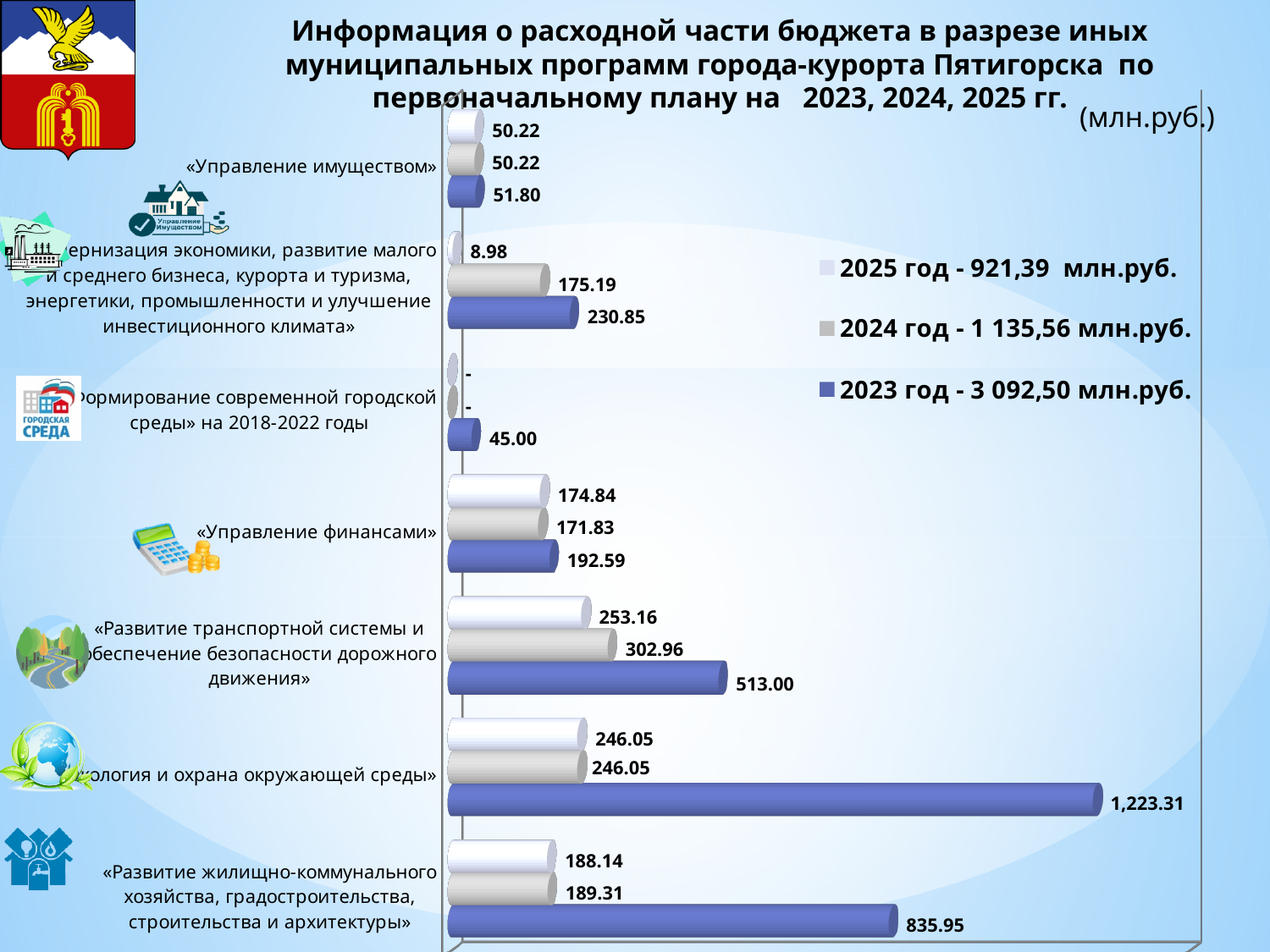
How many program categories are plotted on the chart? 7 Which is larger for «Развитие транспортной системы и обеспечение безопасности дорожного движения»: the 2023 value or the 2025 value? 2023 value What type of chart is shown on the slide? bar chart According to the legend, what is the total for 2023 год? 3 092,50 млн.руб. What is the 2023 value for «Формирование современной городской среды» на 2018-2022 годы? 45.00 How many series does the legend list? 3 What is the difference between the 2023 and 2024 values for «Развитие жилищно-коммунального хозяйства, градостроительства, строительства и архитектуры»? 646.64 Which category has the lowest 2025 value among those with a printed number? «Модернизация экономики, развитие малого и среднего бизнеса, курорта и туризма, энергетики, промышленности и улучшение инвестиционного климата» What is the 2025 value for «Управление финансами»? 174.84 What is the 2024 value for «Развитие транспортной системы и обеспечение безопасности дорожного движения»? 302.96 Which category has the highest 2023 value? «Экология и охрана окружающей среды» What is the 2023 value for «Экология и охрана окружающей среды»? 1,223.31